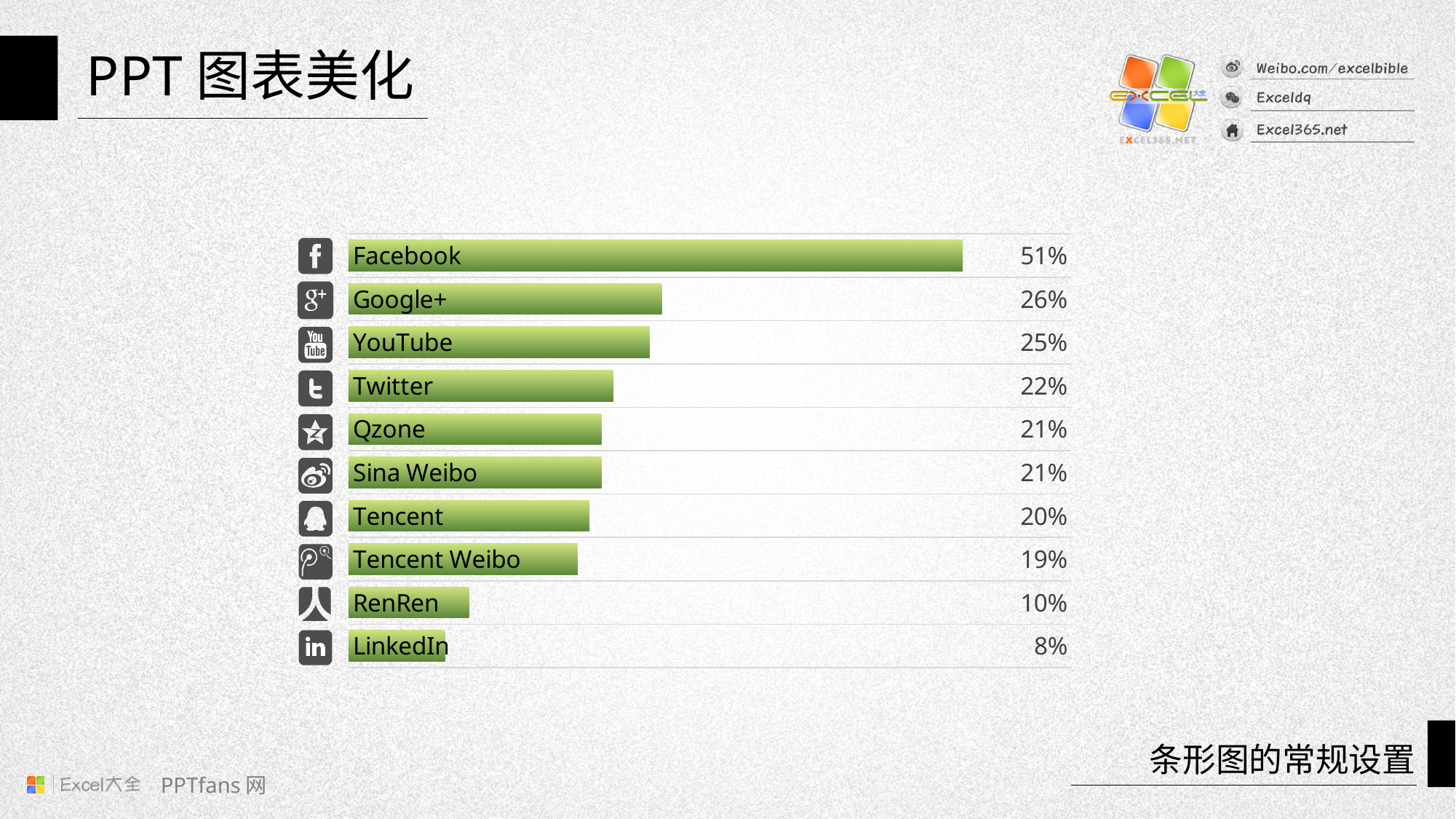
What is the value for Tencent Weibo? 19% What is the difference between the values for RenRen and LinkedIn? 2% Which is larger, the value for Twitter or the value for Tencent? Twitter Which category has the highest value? Facebook Do the values rise or fall going from the top bar to the bottom bar? Fall Which category has the lowest value? LinkedIn What is the value for YouTube? 25% How many categories are shown in the chart? 10 What kind of chart is shown on the slide? Bar chart What colour are the bars in the chart? Green What is the value for Facebook? 51% What is the difference between the values for Facebook and Google+? 25%